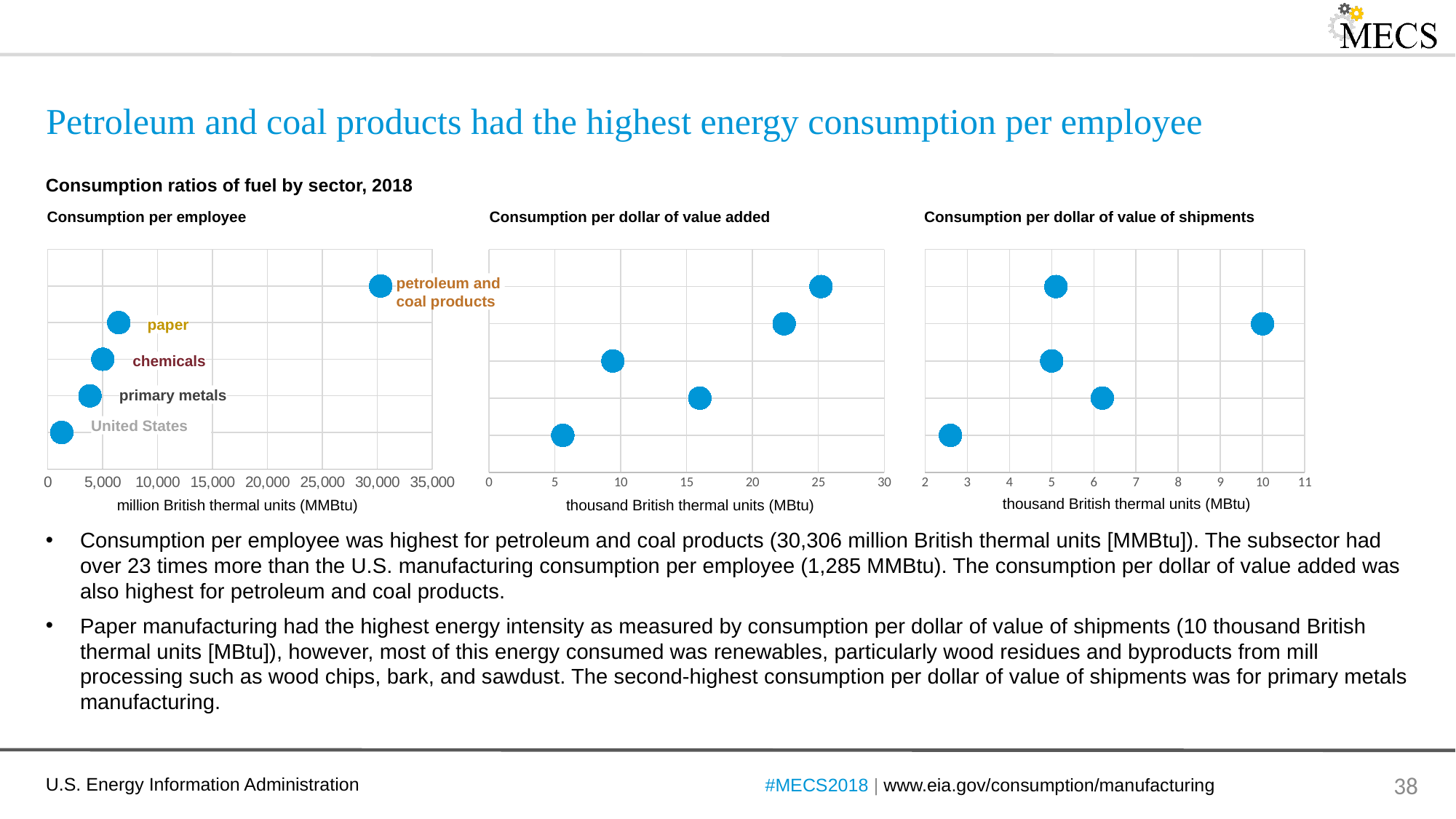
In the 'Consumption per employee' chart, is the value for primary metals greater or less than 5,000 MMBtu? less In the 'Consumption per employee' chart, is the value for petroleum and coal products greater or less than 25,000 MMBtu? greater In the 'Consumption per employee' chart, which sector has the highest consumption per employee? petroleum and coal products In the 'Consumption per employee' chart, which category has the lowest value? United States What unit is shown on the x axis of the 'Consumption per dollar of value of shipments' chart? thousand British thermal units (MBtu) How many charts are shown on the slide? 3 In the 'Consumption per dollar of value added' chart, is the highest plotted value greater or less than 20 MBtu? greater In the 'Consumption per employee' chart, which is larger: the value for paper or the value for chemicals? paper What kind of chart is the 'Consumption per dollar of value added' chart? scatter (dot) chart How many data points are plotted in the 'Consumption per employee' chart? 5